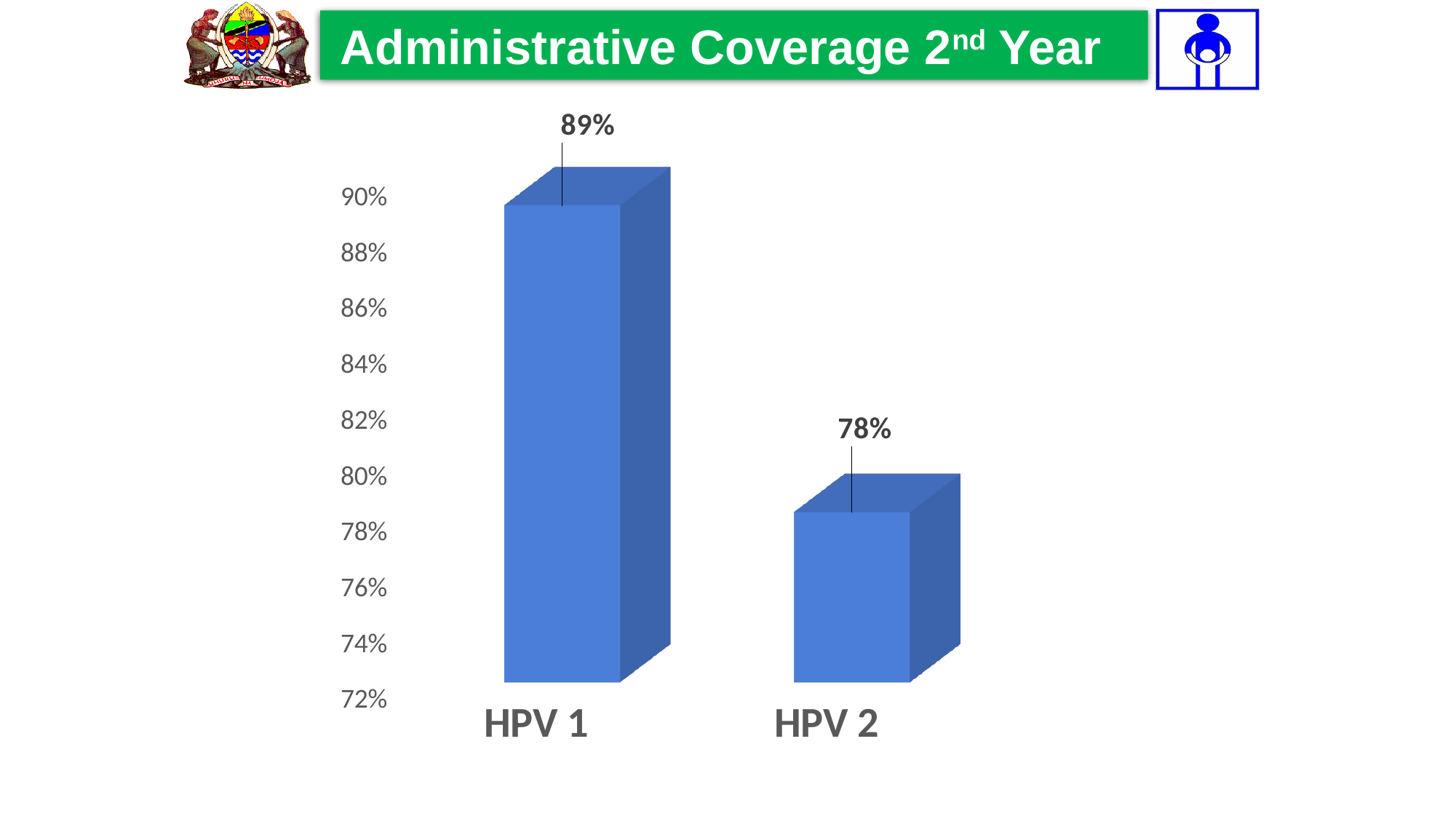
Do the values rise or fall from HPV 1 to HPV 2? fall What is the value for HPV 1? 89% Is the value for HPV 2 greater or less than 80%? less Which category has the lowest value? HPV 2 How many categories are shown on the chart? 2 What is the title of the slide? Administrative Coverage 2nd Year What is the value for HPV 2? 78% Which category has the highest value? HPV 1 What is the difference between the values for HPV 1 and HPV 2? 11% What kind of chart is shown on the slide? bar chart Is the value for HPV 1 greater or less than 86%? greater Which is larger, the value for HPV 1 or HPV 2? HPV 1